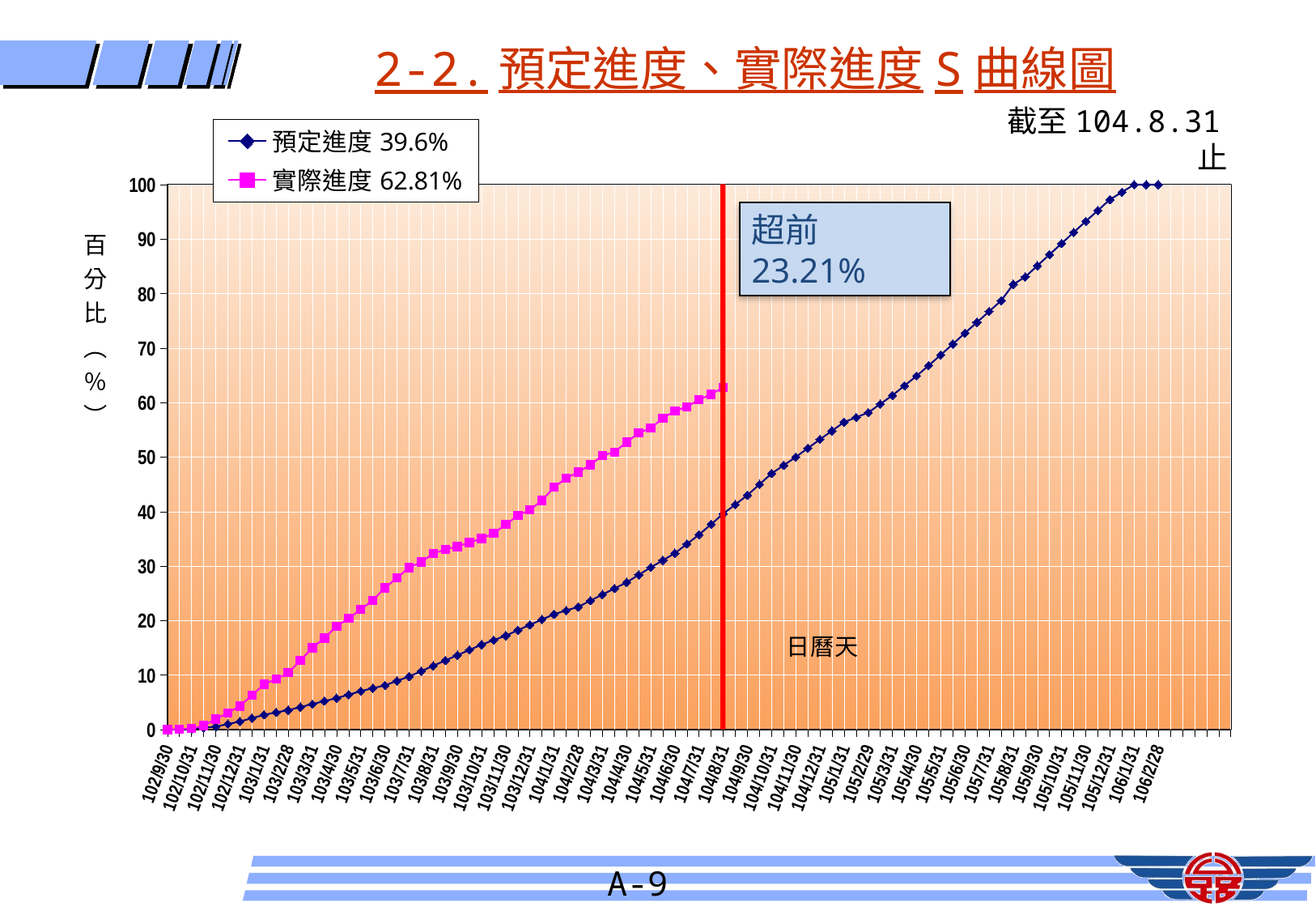
What kind of chart is shown on the slide? line chart Is the value of 預定進度 at 104/3/31 greater or less than 30? less What text is shown in the annotation box on the chart? 超前 23.21% Do the values of 預定進度 rise or fall along the x axis? rise At 104/8/31, which series is higher, 預定進度 or 實際進度? 實際進度 Is the value of 預定進度 at 105/3/31 greater or less than 50? greater By how much does 實際進度 exceed 預定進度 as of 104.8.31? 23.21% According to the legend, what is the value of 預定進度 as of 104.8.31? 39.6% How many series does the legend list? 2 Is the value of 實際進度 at 104/3/31 greater or less than 40? greater What is the title of the chart? 2-2. 預定進度、實際進度 S 曲線圖 According to the legend, what is the value of 實際進度 as of 104.8.31? 62.81%